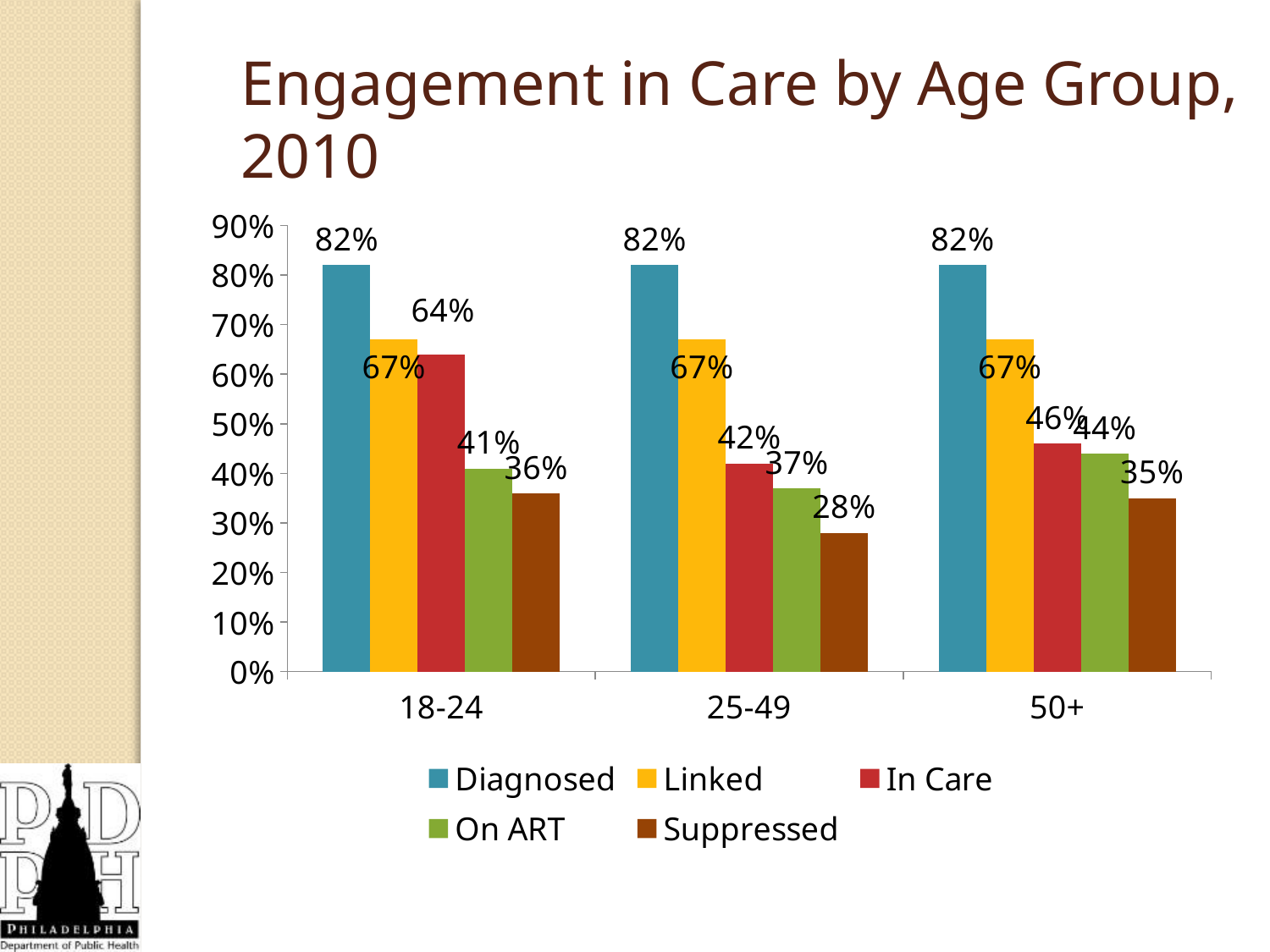
What is the title of the chart? Engagement in Care by Age Group, 2010 Which age group has the lowest Suppressed value? 25-49 How many series does the legend list? 5 What is the In Care value for the 50+ age group? 46% What is the Suppressed value for the 25-49 age group? 28% How many age groups are shown on the x axis? 3 What is the Diagnosed value for the 25-49 age group? 82% Is the In Care value for the 18-24 age group larger or smaller than the In Care value for the 25-49 age group? larger What is the difference between the Diagnosed and Suppressed values for the 50+ age group? 47% Which age group has the highest In Care value? 18-24 What kind of chart is shown on the slide? bar chart What is the On ART value for the 18-24 age group? 41%